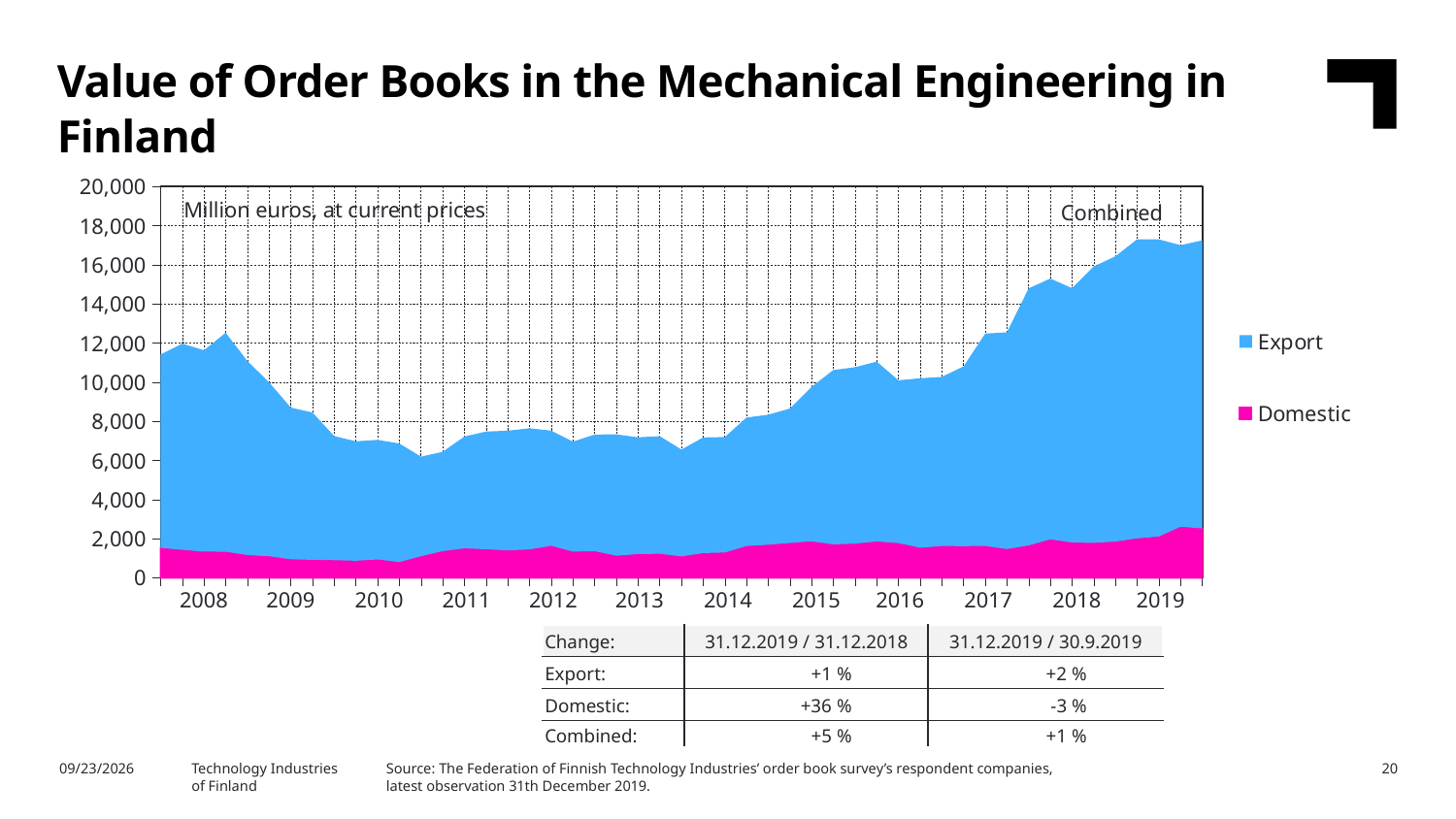
According to the table, what is the Combined change for 31.12.2019 / 30.9.2019? +1 % Is the Domestic value at the end of 2019 greater or less than 2,000? greater Which series is larger throughout the chart, Export or Domestic? Export Does the combined value rise or fall from 2016 to 2019? rise According to the table, what is the Domestic change for 31.12.2019 / 31.12.2018? +36 % Is the combined value in 2011 greater or less than 8,000? less Is the combined value at the end of 2019 greater or less than 16,000? greater What kind of chart is shown on the slide? Stacked area chart What unit is stated in the chart's annotation? Million euros, at current prices How many years are labelled on the x axis? 12 What are the two series named in the legend? Export and Domestic How many series does the legend list? 2